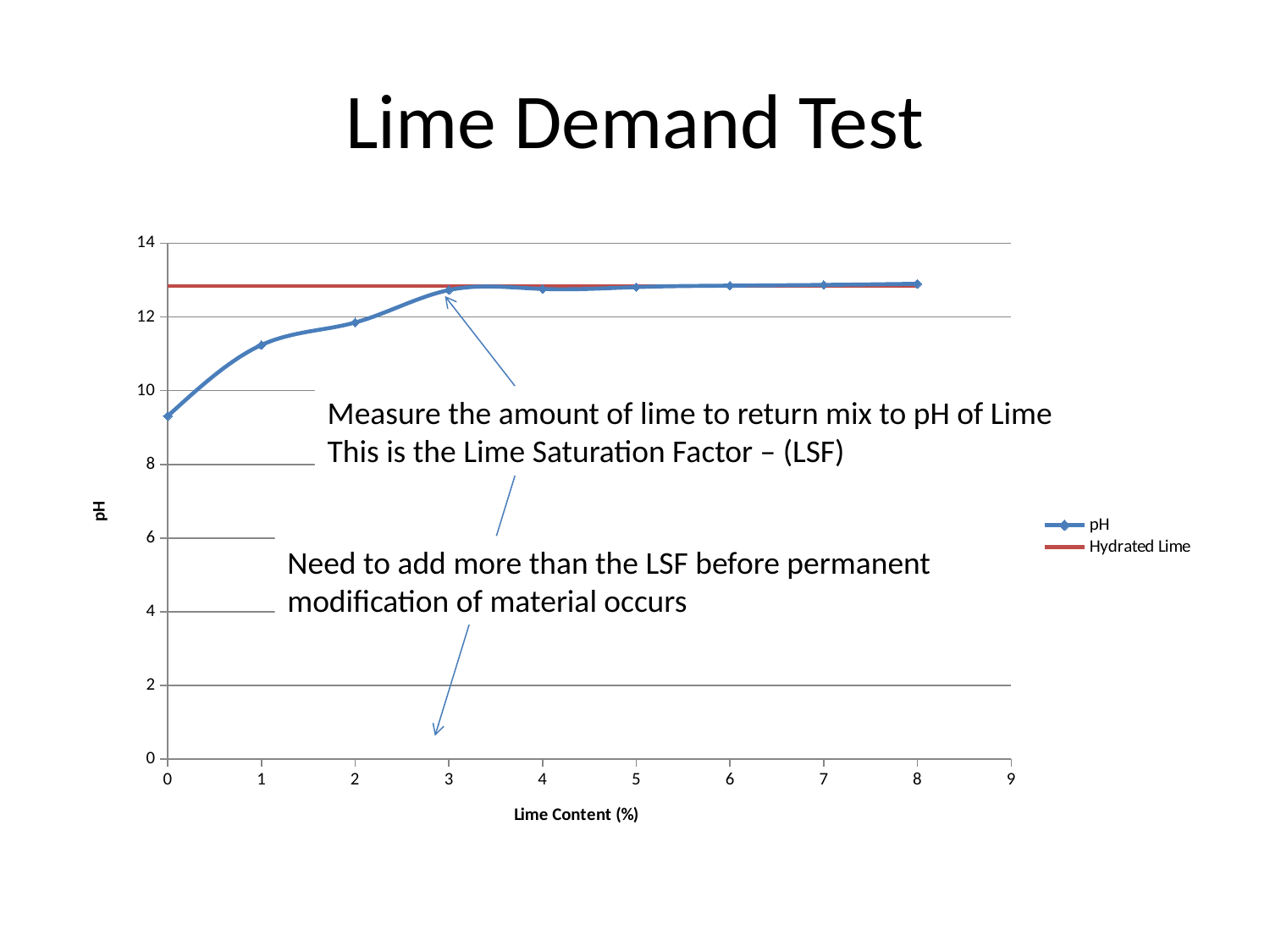
Which is larger, the pH at a lime content of 0 or the pH at a lime content of 2? lime content of 2 Is the pH value at a lime content of 3 greater or less than 12? greater How many data points are plotted on the pH line? 9 Is the pH value at a lime content of 1 greater or less than 10? greater What kind of chart is shown on the slide? line chart Does the pH line rise or fall as lime content increases from 0 to 8? rises Is the pH value at a lime content of 0 greater or less than 10? less What are the two series named in the legend? pH and Hydrated Lime How many series does the legend list? 2 At which lime content is the pH lowest? 0 What is the title of the x axis? Lime Content (%)